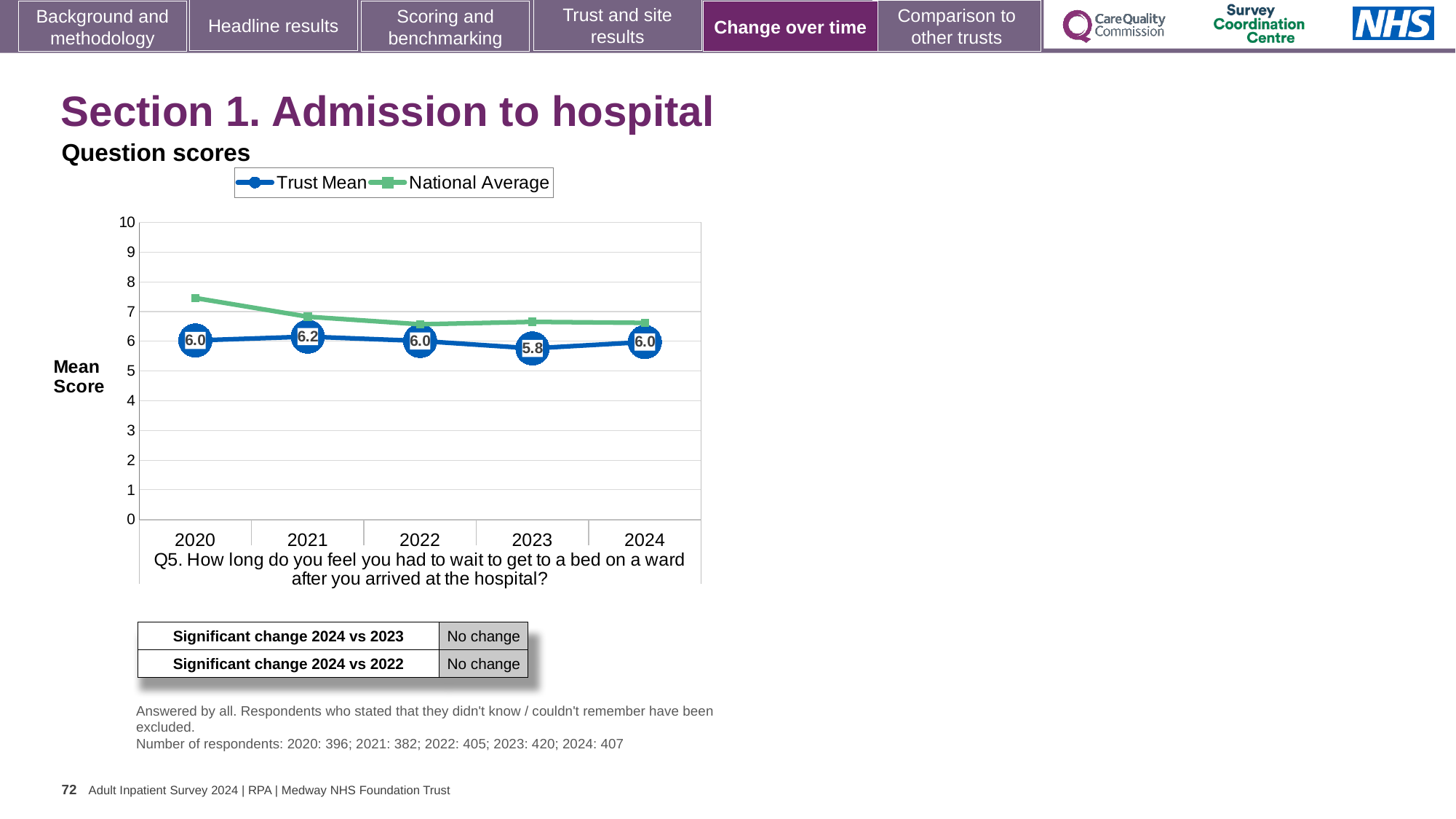
What is the difference between the Trust Mean scores for 2021 and 2023? 0.4 What kind of chart is shown? line chart How many years are shown on the x axis? 5 In which year is the Trust Mean score highest? 2021 What is the Trust Mean score for 2023? 5.8 What is the Trust Mean score for 2021? 6.2 Is the National Average value for 2020 greater or less than 7? greater In which year is the Trust Mean score lowest? 2023 What is the Trust Mean score for 2024? 6.0 How many series does the legend list? 2 Is the National Average value for 2022 greater or less than 7? less Which is larger, the Trust Mean score for 2021 or for 2023? 2021